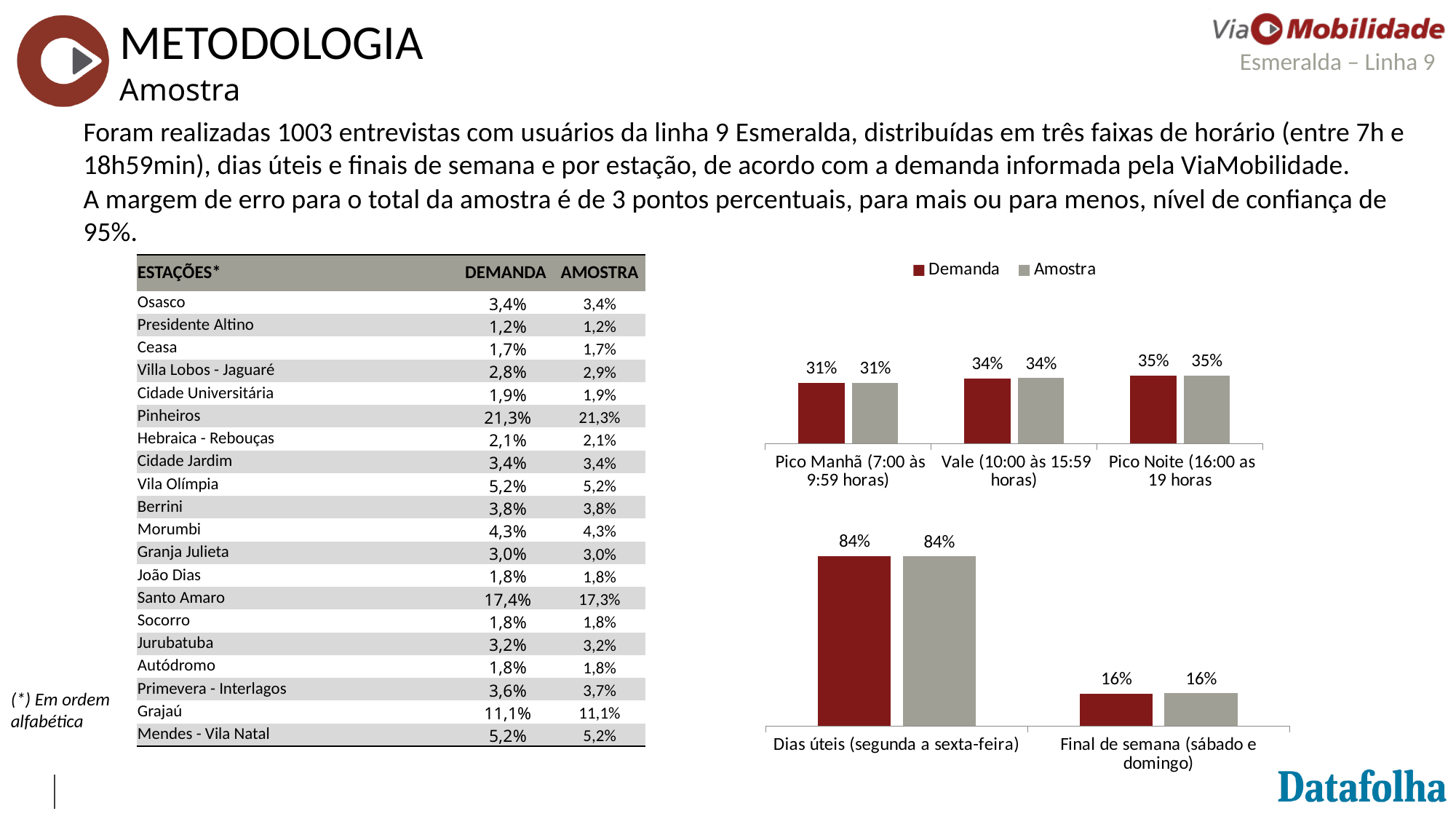
In the bottom chart on the right, which category has the larger Demanda value, Dias úteis or Final de semana? Dias úteis (segunda a sexta-feira) What type of chart is the bottom chart on the right? Bar chart In the top chart on the right, how many time-band categories are shown? 3 In the top chart on the right, what is the difference between the Demanda values for Pico Noite and Pico Manhã? 4 percentage points In the bottom chart on the right, what is the Amostra value for Final de semana (sábado e domingo)? 16% In the top chart on the right, what is the Demanda value for Pico Manhã (7:00 às 9:59 horas)? 31% In the top chart on the right, what is the Amostra value for Vale (10:00 às 15:59 horas)? 34% In the bottom chart on the right, what is the difference between the Amostra values for Dias úteis and Final de semana? 68 percentage points In the bottom chart on the right, what is the Demanda value for Dias úteis (segunda a sexta-feira)? 84% In the top chart on the right, how many series does the legend list? 2 In the top chart on the right, which time band has the highest Demanda value? Pico Noite (16:00 as 19 horas) In the top chart on the right, which time band has the lowest Amostra value? Pico Manhã (7:00 às 9:59 horas)